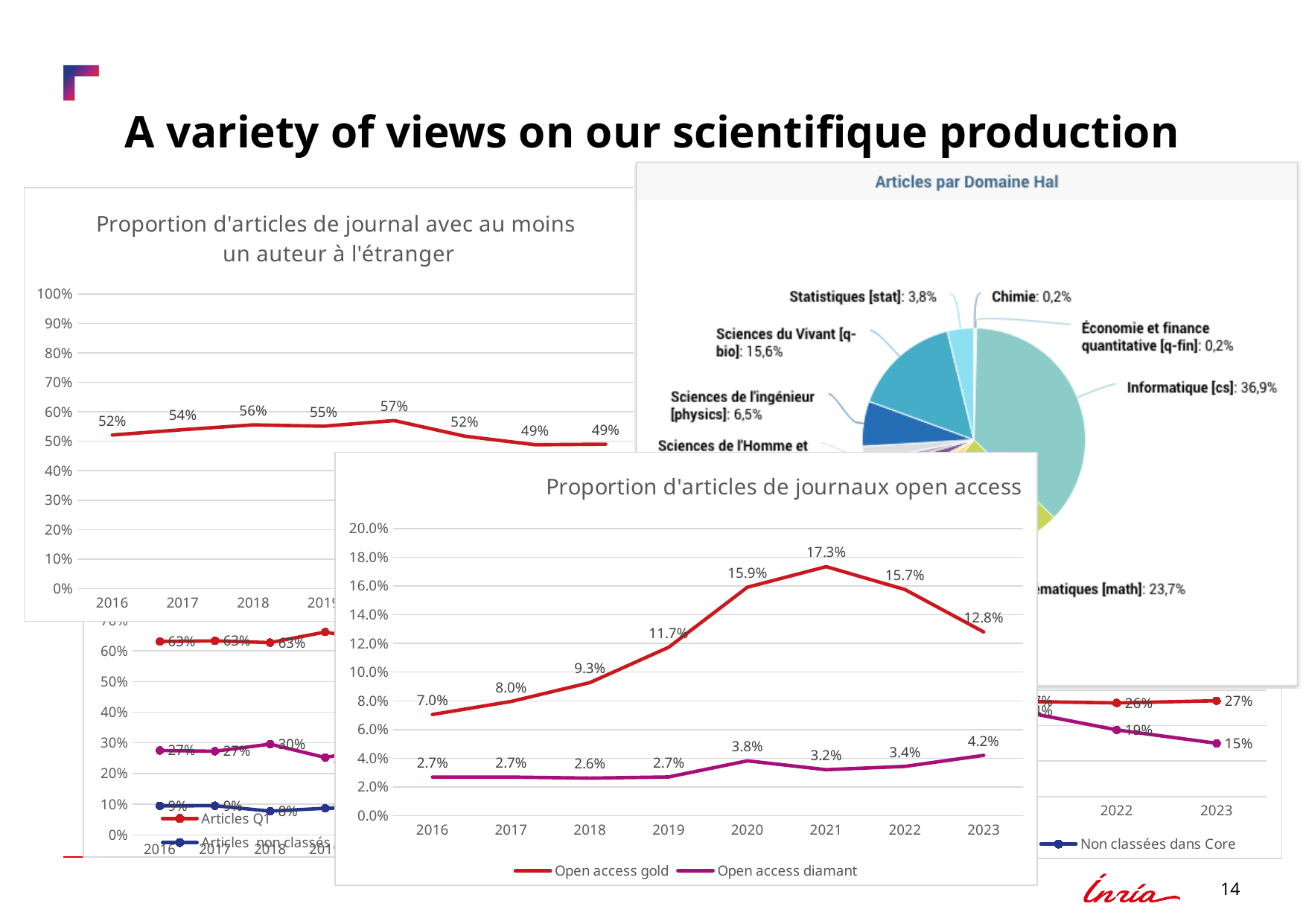
In the chart 'Proportion d'articles de journaux open access', what is the difference between the Open access gold values for 2021 and 2023? 4.5 percentage points In the chart 'Proportion d'articles de journal avec au moins un auteur à l'étranger', what is the highest value shown? 57% In the chart 'Proportion d'articles de journaux open access', how many series does the legend list? 2 In the chart 'Proportion d'articles de journaux open access', what is the Open access gold value for 2021? 17.3% In the chart 'Proportion d'articles de journaux open access', how many years are plotted on the x axis? 8 In the chart 'Proportion d'articles de journaux open access', what is the Open access diamant value for 2023? 4.2% In the chart 'Proportion d'articles de journal avec au moins un auteur à l'étranger', what is the value for 2018? 56% In the chart 'Proportion d'articles de journaux open access', does the Open access gold value rise or fall from 2016 to 2021? Rise In the pie chart 'Articles par Domaine Hal', what share does Informatique [cs] have? 36,9% In the chart 'Proportion d'articles de journaux open access', in which year is the Open access gold value lowest? 2016 What kind of chart is 'Proportion d'articles de journaux open access'? Line chart In the chart 'Proportion d'articles de journaux open access', in which year is the Open access gold value highest? 2021